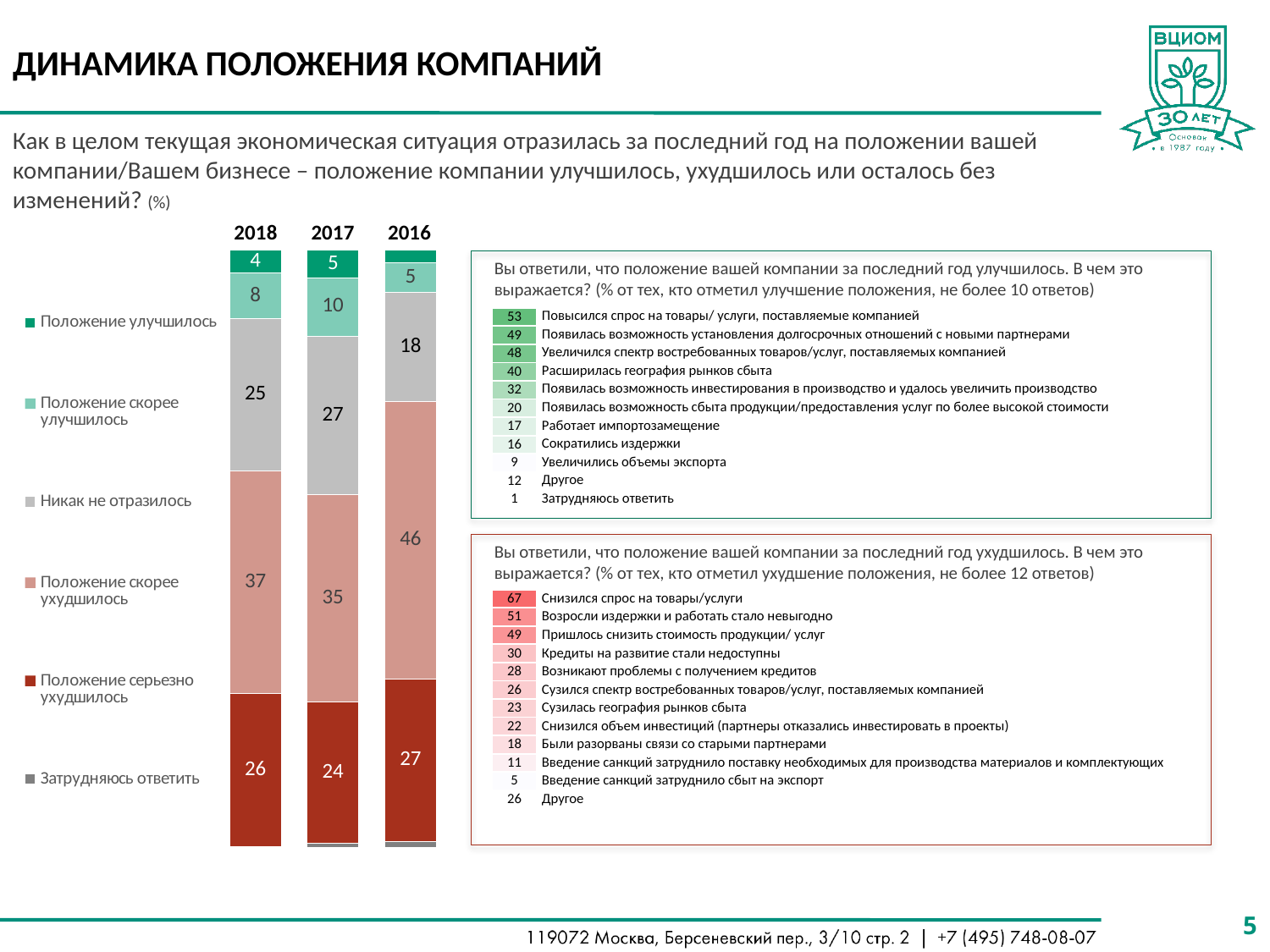
In the stacked bar chart, what is the difference between the 2016 and 2017 values for "Положение скорее ухудшилось"? 11 In the stacked bar chart, which year has the highest value for "Положение скорее ухудшилось"? 2016 In the stacked bar chart, is the value for "Никак не отразилось" larger in 2018 or in 2016? 2018 What kind of chart is shown on the left of the slide? Stacked bar chart How many years (bars) are shown in the stacked bar chart? 3 In the stacked bar chart, what is the value for "Положение серьезно ухудшилось" in 2018? 26 In the stacked bar chart, what is the value for "Положение скорее ухудшилось" in 2016? 46 In the stacked bar chart, what is the difference between the 2017 and 2018 values for "Положение скорее улучшилось"? 2 In the stacked bar chart, which year has the lowest value for "Положение серьезно ухудшилось"? 2017 In the stacked bar chart, what is the value for "Положение скорее ухудшилось" in 2018? 37 How many series does the legend of the stacked bar chart list? 6 In the stacked bar chart, what is the value for "Никак не отразилось" in 2017? 27